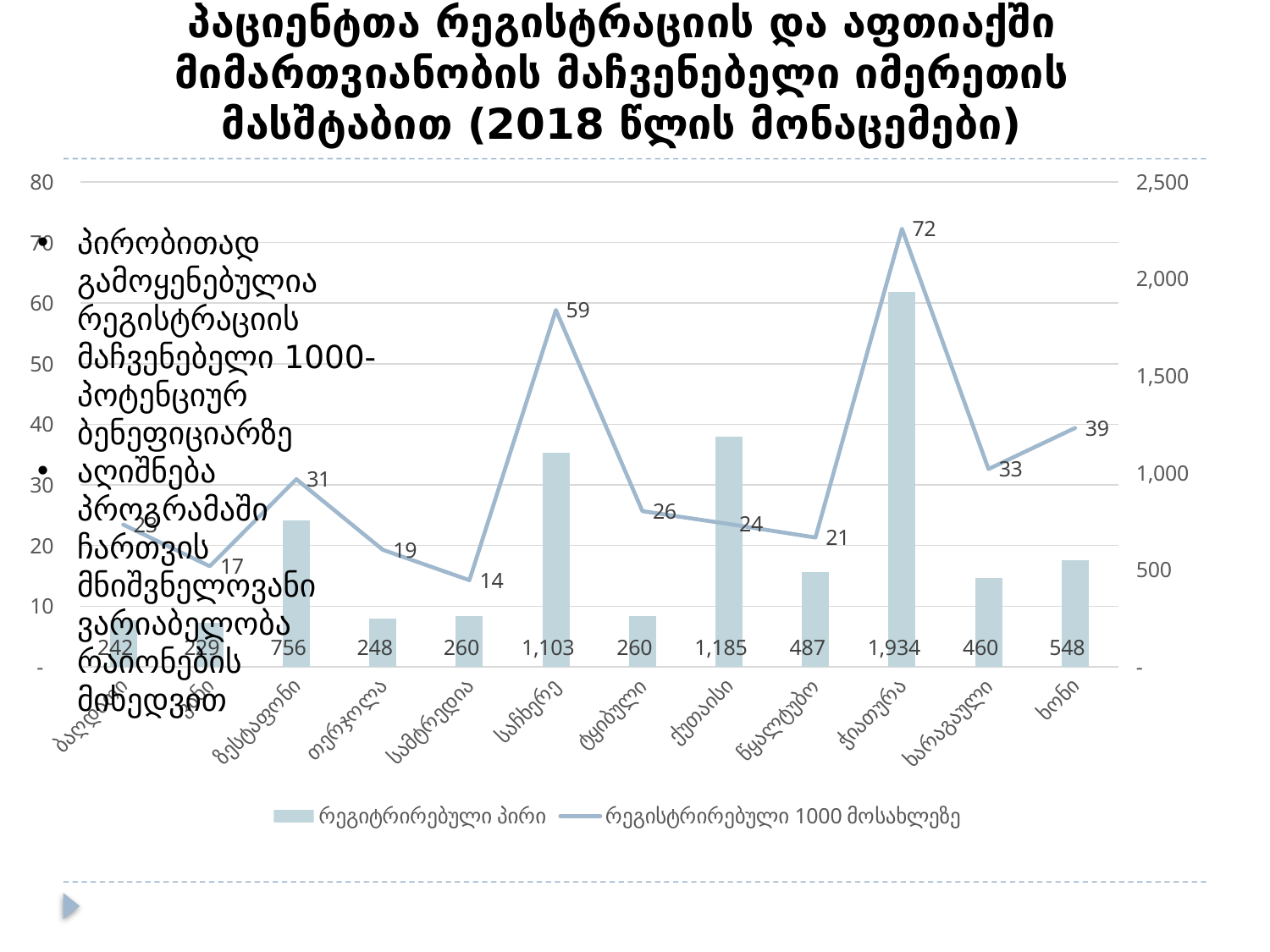
Which category has the highest value of რეგისტრირებული 1000 მოსახლეზე? ჭიათურა Which category has the highest value of რეგიტრირებული პირი? ჭიათურა Which has a higher value of რეგიტრირებული პირი, ხონი or ხარაგაული? ხონი What is the value of რეგისტრირებული 1000 მოსახლეზე for საჩხერე? 59 Which category has the lowest value of რეგისტრირებული 1000 მოსახლეზე? სამტრედია What is the difference in რეგისტრირებული 1000 მოსახლეზე between ჭიათურა and ხარაგაული? 39 What is the difference in რეგიტრირებული პირი between ქუთაისი and საჩხერე? 82 How many series does the legend list? 2 What is the value of რეგიტრირებული პირი for წყალტუბო? 487 What kind of chart is shown on the slide? Combined bar and line chart What is the value of რეგისტრირებული 1000 მოსახლეზე for ხონი? 39 What is the value of რეგიტრირებული პირი for ჭიათურა? 1,934